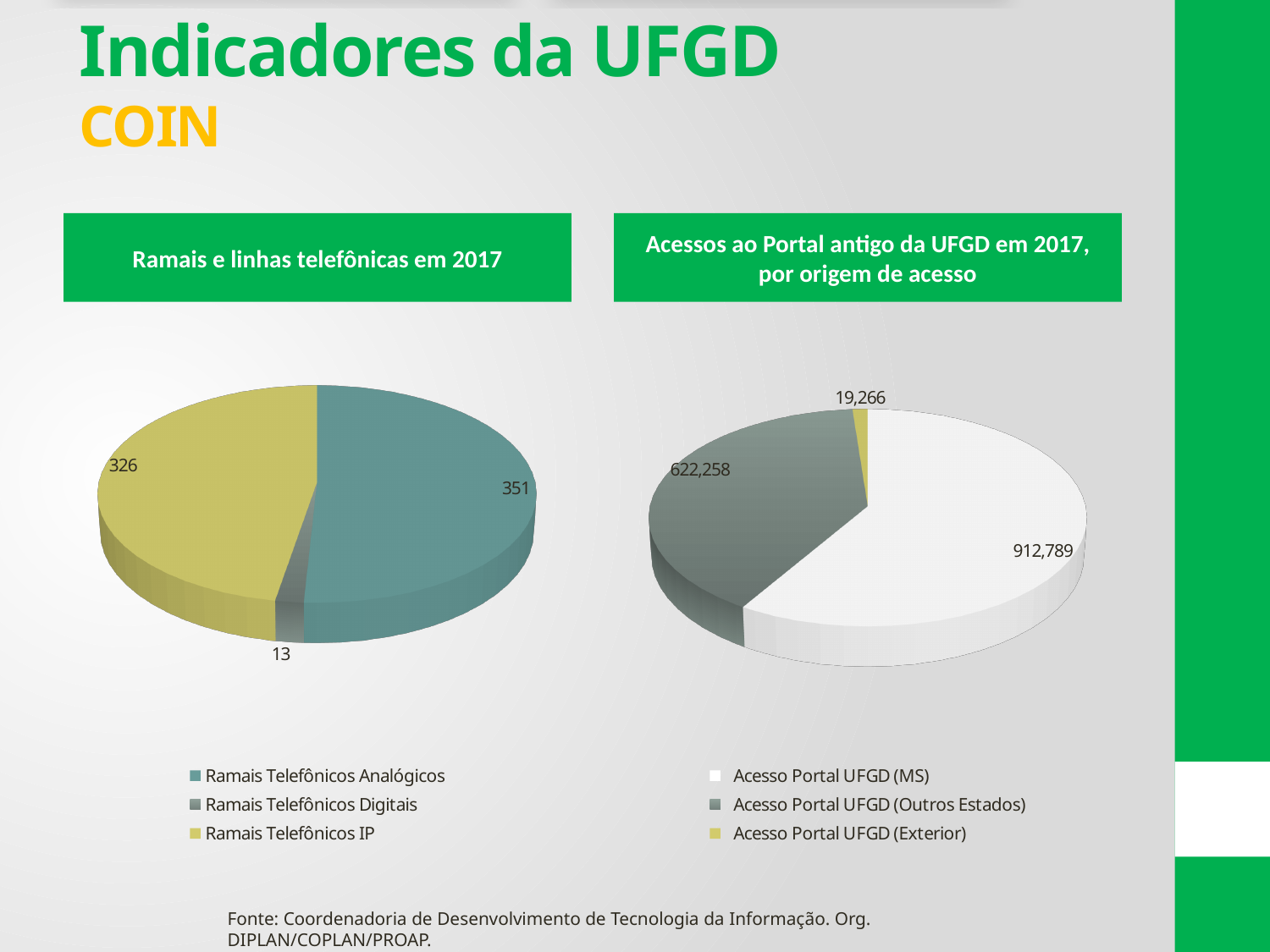
In the chart 'Acessos ao Portal antigo da UFGD em 2017, por origem de acesso', what is the difference between Acesso Portal UFGD (MS) and Acesso Portal UFGD (Outros Estados)? 290,531 In the chart 'Ramais e linhas telefônicas em 2017', which category has the smallest value? Ramais Telefônicos Digitais In the chart 'Acessos ao Portal antigo da UFGD em 2017, por origem de acesso', what is the value for Acesso Portal UFGD (Outros Estados)? 622,258 In the chart 'Acessos ao Portal antigo da UFGD em 2017, por origem de acesso', what is the value for Acesso Portal UFGD (Exterior)? 19,266 What type of chart is 'Acessos ao Portal antigo da UFGD em 2017, por origem de acesso'? Pie chart In the chart 'Acessos ao Portal antigo da UFGD em 2017, por origem de acesso', which is larger: Acesso Portal UFGD (Outros Estados) or Acesso Portal UFGD (Exterior)? Acesso Portal UFGD (Outros Estados) In the chart 'Ramais e linhas telefônicas em 2017', what is the value for Ramais Telefônicos Analógicos? 351 In the chart 'Acessos ao Portal antigo da UFGD em 2017, por origem de acesso', which category has the largest value? Acesso Portal UFGD (MS) In the chart 'Ramais e linhas telefônicas em 2017', what is the value for Ramais Telefônicos Digitais? 13 How many categories does the chart 'Ramais e linhas telefônicas em 2017' show? 3 In the chart 'Ramais e linhas telefônicas em 2017', what is the difference between Ramais Telefônicos Analógicos and Ramais Telefônicos IP? 25 In the chart 'Ramais e linhas telefônicas em 2017', what is the total of all three categories? 690